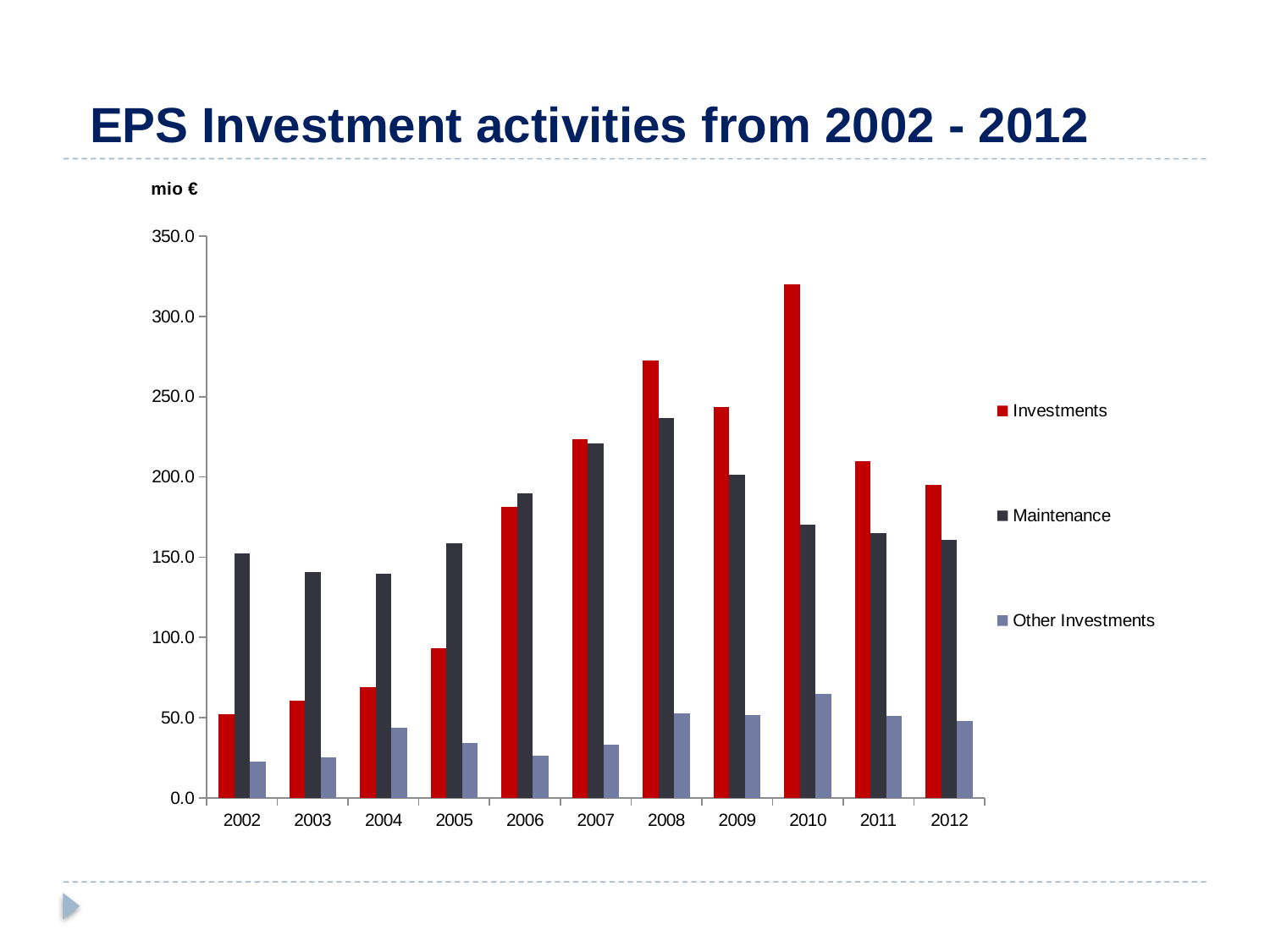
In which year is the Investments value lowest? 2002 In which year is the Other Investments value highest? 2010 In which year is the Maintenance value highest? 2008 Is the Investments value for 2010 greater or less than 300.0? greater Is the Maintenance value for 2003 greater or less than 150.0? less In 2008, which is larger: Investments or Maintenance? Investments What kind of chart is shown on the slide? bar chart How many series does the legend list? 3 In 2002, which is larger: Investments or Maintenance? Maintenance What unit is shown above the y axis? mio € In which year is the Investments value highest? 2010 How many years are shown on the x axis? 11